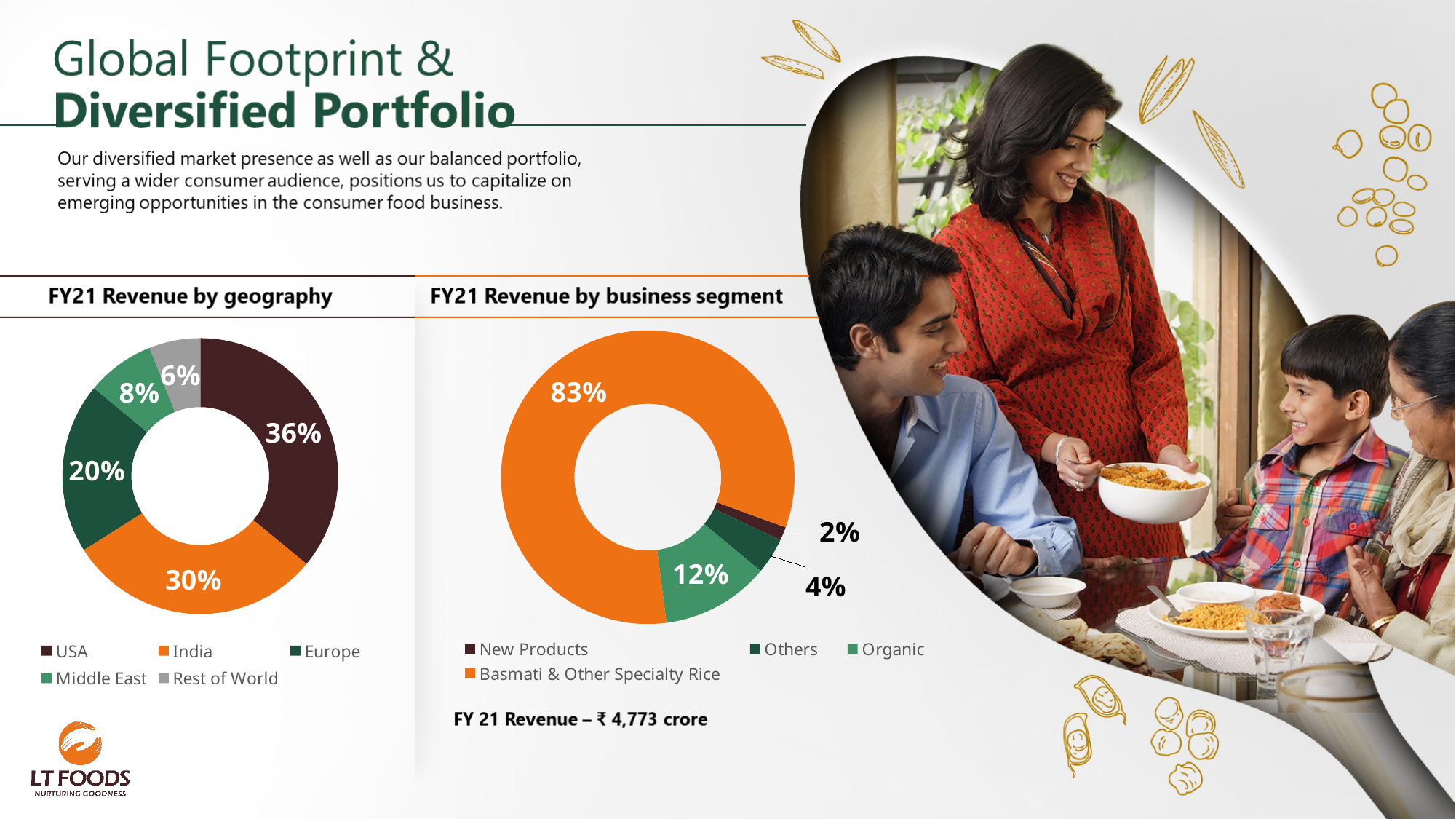
In the FY21 Revenue by geography chart, what is the difference between the USA and India shares? 6% In the FY21 Revenue by business segment chart, which segment has the smallest share? New Products What kind of chart is the FY21 Revenue by geography chart? Donut (pie) chart In the FY21 Revenue by geography chart, which region has the smallest share? Rest of World In the FY21 Revenue by geography chart, what share of revenue comes from Europe? 20% In the FY21 Revenue by geography chart, how many regions are shown? 5 In the FY21 Revenue by business segment chart, which is larger, Others or New Products? Others In the FY21 Revenue by geography chart, which region has the largest share? USA What total FY21 revenue figure is printed below the business segment chart? ₹ 4,773 crore In the FY21 Revenue by business segment chart, what share comes from Organic? 12% In the FY21 Revenue by geography chart, what share of revenue comes from the USA? 36% In the FY21 Revenue by business segment chart, what share comes from Basmati & Other Specialty Rice? 83%